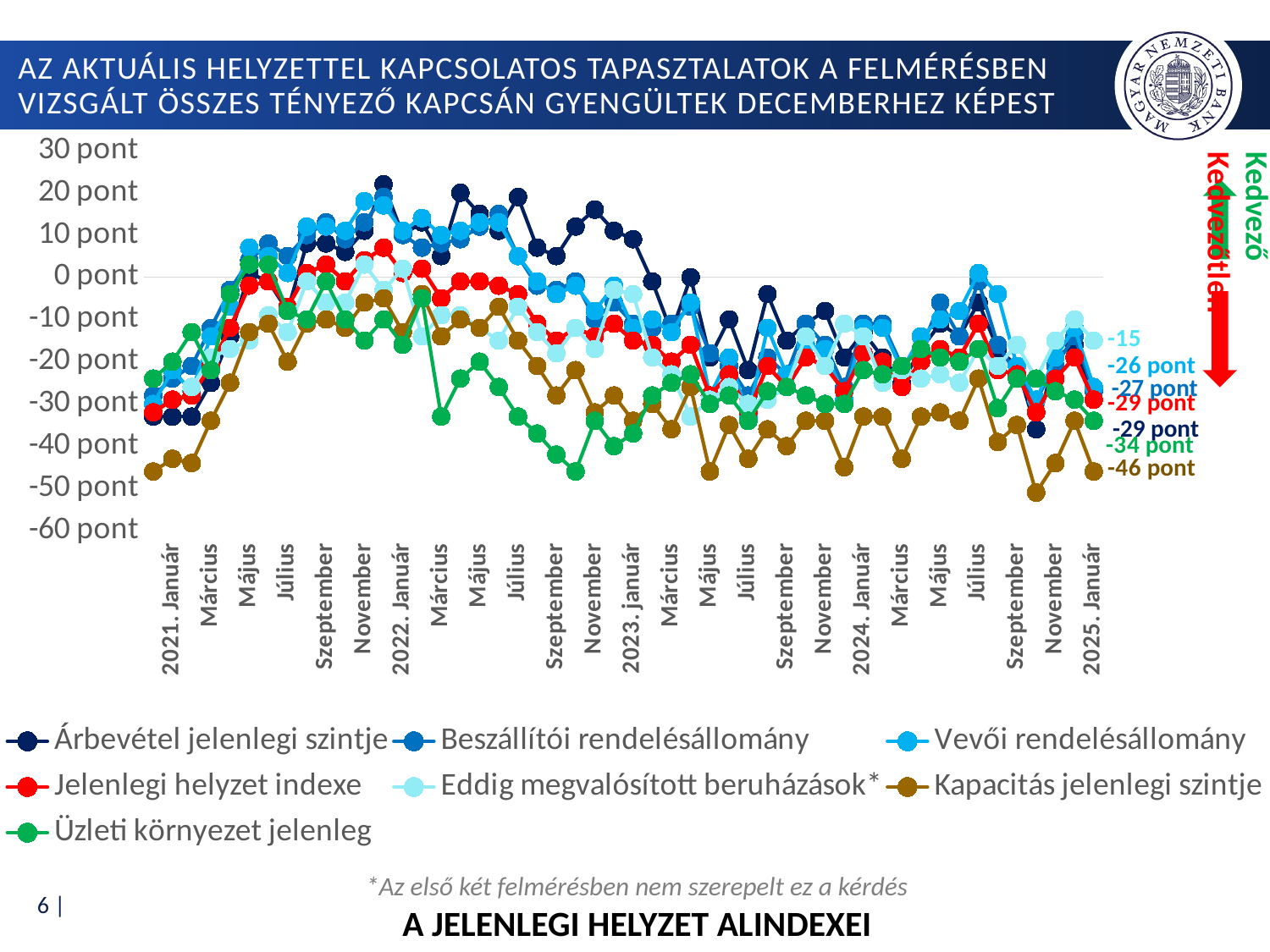
Which series has the lowest value at 2025. Január? Kapacitás jelenlegi szintje At 2025. Január, which is higher: Vevői rendelésállomány or Beszállítói rendelésállomány? Vevői rendelésállomány What is the value of Eddig megvalósított beruházások at 2025. Január? -15 What is the value of Kapacitás jelenlegi szintje at 2025. Január? -46 pont Which series has the highest value at 2025. Január? Eddig megvalósított beruházások What is the title shown below the chart? A JELENLEGI HELYZET ALINDEXEI What is the value of Vevői rendelésállomány at 2025. Január? -26 pont What is the value of Üzleti környezet jelenleg at 2025. Január? -34 pont What is the difference between Üzleti környezet jelenleg and Kapacitás jelenlegi szintje at 2025. Január? 12 pont Is the value of Kapacitás jelenlegi szintje at 2021. Január greater or less than -40 pont? less How many series does the legend list? 7 What kind of chart is shown on the slide? line chart